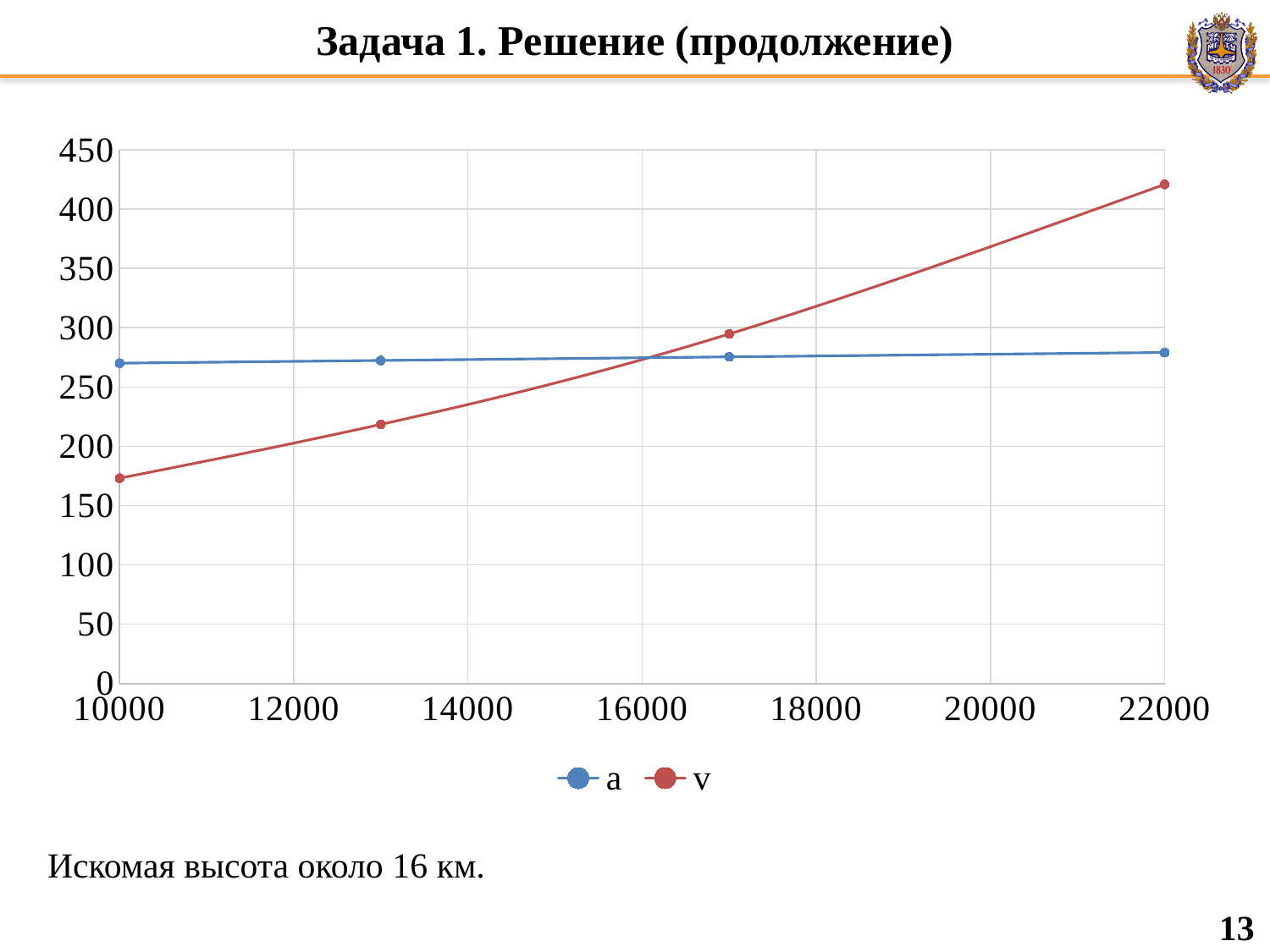
What are the names of the two series in the legend? a and v Is the value of series v at x = 13000 greater or less than 250? less Is the value of series v at x = 10000 greater or less than 200? less How many data points are plotted for series v? 4 Is the value of series a at x = 10000 greater or less than 250? greater At x = 10000, which series has the larger value, a or v? a What kind of chart is shown on the slide? line chart Do the values of series v rise or fall as x increases from 10000 to 22000? rise How many series does the legend list? 2 At x = 22000, which series has the larger value, a or v? v What colour is the line for series v? red